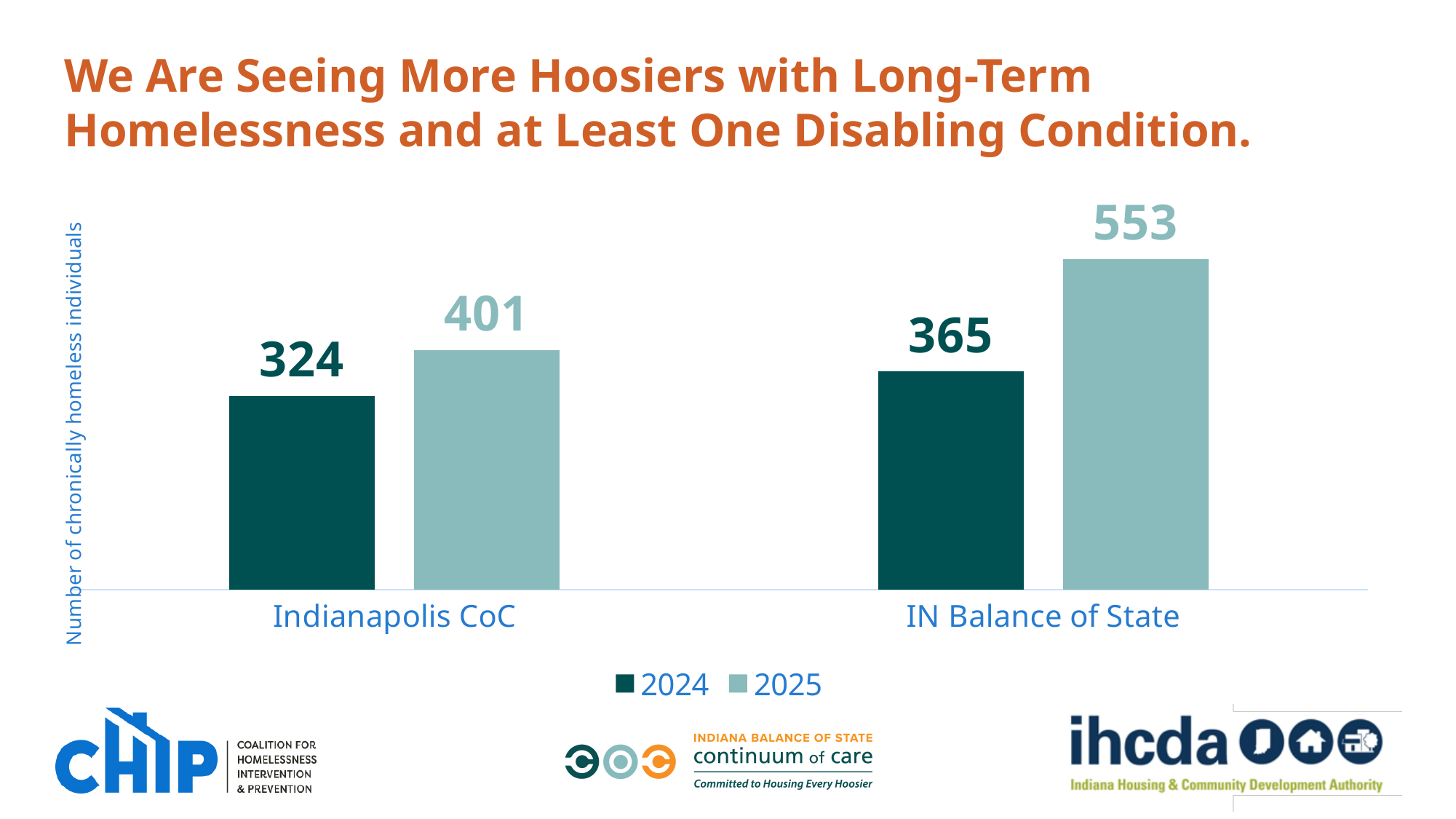
How many categories are shown on the x axis? 2 What is the difference between the 2025 and 2024 values for Indianapolis CoC? 77 Which category has the lowest 2024 value? Indianapolis CoC What is the 2025 value for IN Balance of State? 553 What kind of chart is shown on the slide? Bar chart What is the 2024 value for Indianapolis CoC? 324 What is the difference between the 2025 and 2024 values for IN Balance of State? 188 Which is larger: the 2025 value for Indianapolis CoC or the 2024 value for IN Balance of State? 2025 value for Indianapolis CoC What is the 2025 value for Indianapolis CoC? 401 How many series does the legend list? 2 Which category has the highest 2025 value? IN Balance of State What is the 2024 value for IN Balance of State? 365